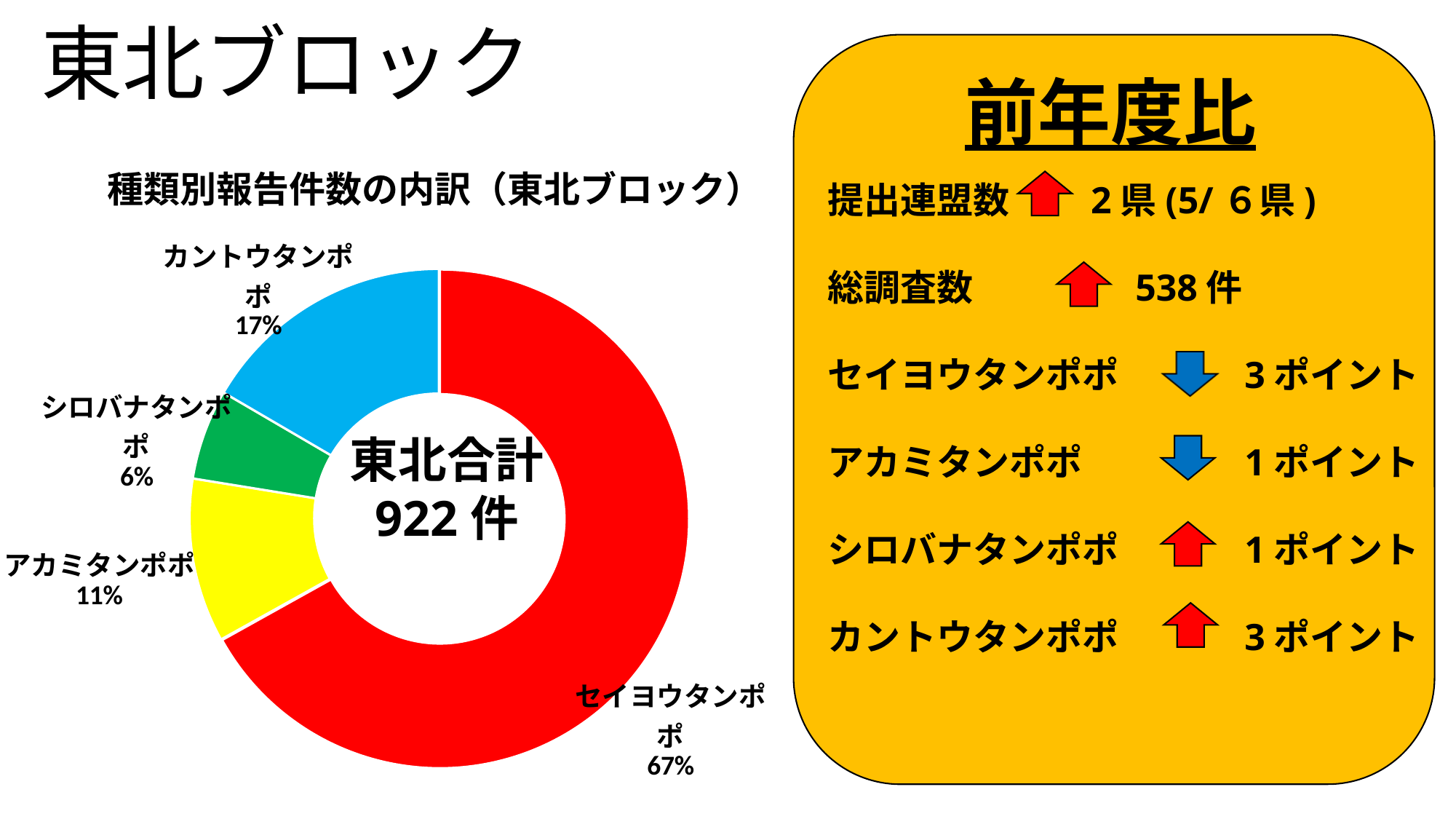
What is the title of the chart? 種類別報告件数の内訳（東北ブロック） What total number of cases is shown in the centre of the chart? 922 件 What share of the chart does セイヨウタンポポ account for? 67% What share of the chart does アカミタンポポ account for? 11% What share of the chart does カントウタンポポ account for? 17% Which category has the largest share of the chart? セイヨウタンポポ Which category has the smallest share of the chart? シロバナタンポポ How many categories are shown in the chart? 4 What is the difference in percentage points between セイヨウタンポポ and カントウタンポポ? 50 percentage points What kind of chart is shown on the slide? Doughnut (pie) chart Which has the larger share, アカミタンポポ or シロバナタンポポ? アカミタンポポ